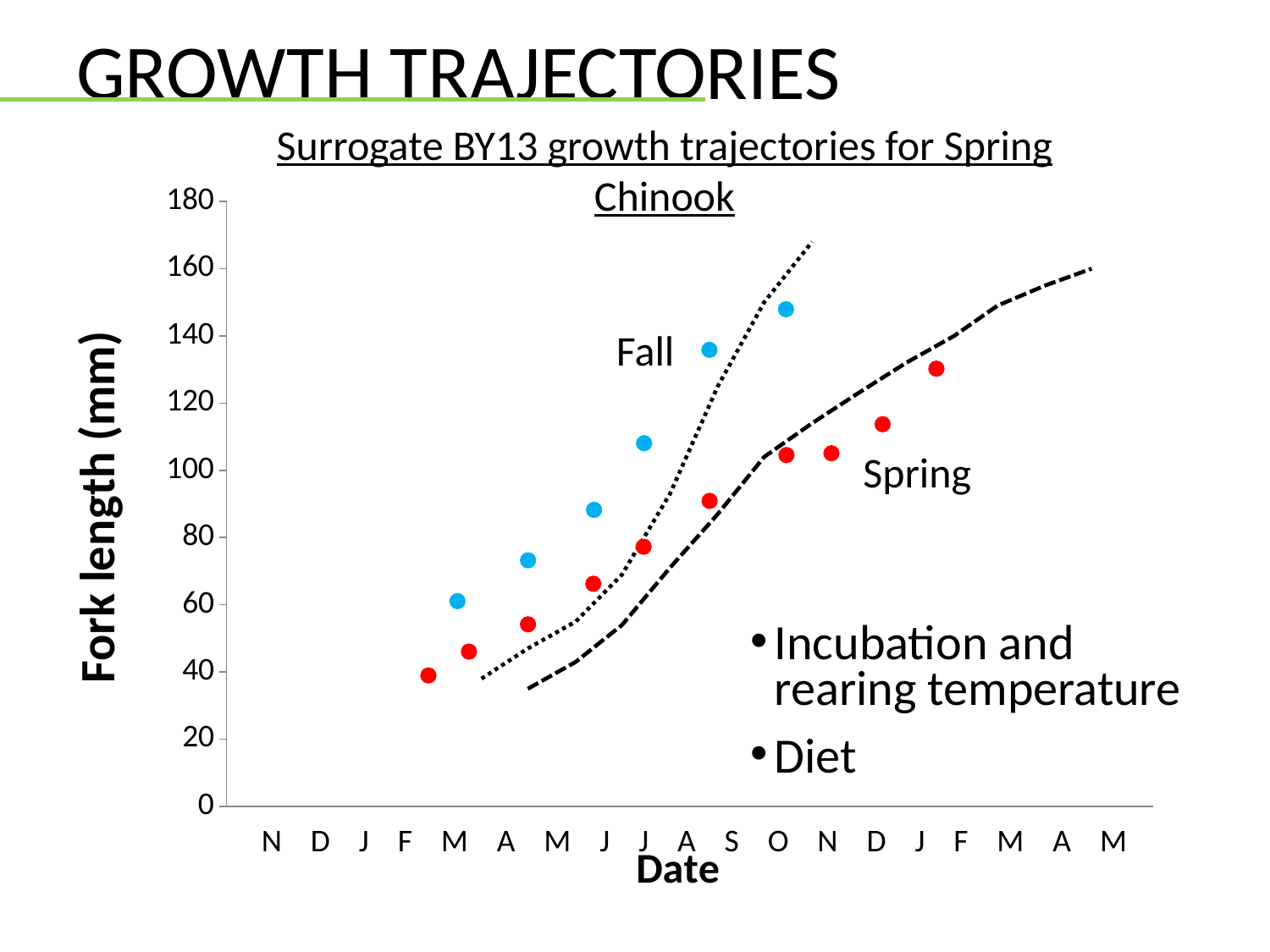
What is the title of the chart? Surrogate BY13 growth trajectories for Spring Chinook Is the lowest Spring data point greater or less than 60 mm? less Which series, Fall or Spring, reaches the higher fork length on the chart? Fall Do the fork length values for the Spring series rise or fall over time along the x axis? rise What kind of chart is shown on the slide? line chart Do the fork length values for the Fall series rise or fall over time along the x axis? rise Is the lowest Fall data point greater or less than 80 mm? less What is the maximum value shown on the vertical axis of the chart? 180 What is the label of the vertical axis? Fork length (mm) Is the highest Fall data point greater or less than 140 mm? greater How many Fall (blue) data points are plotted on the chart? 6